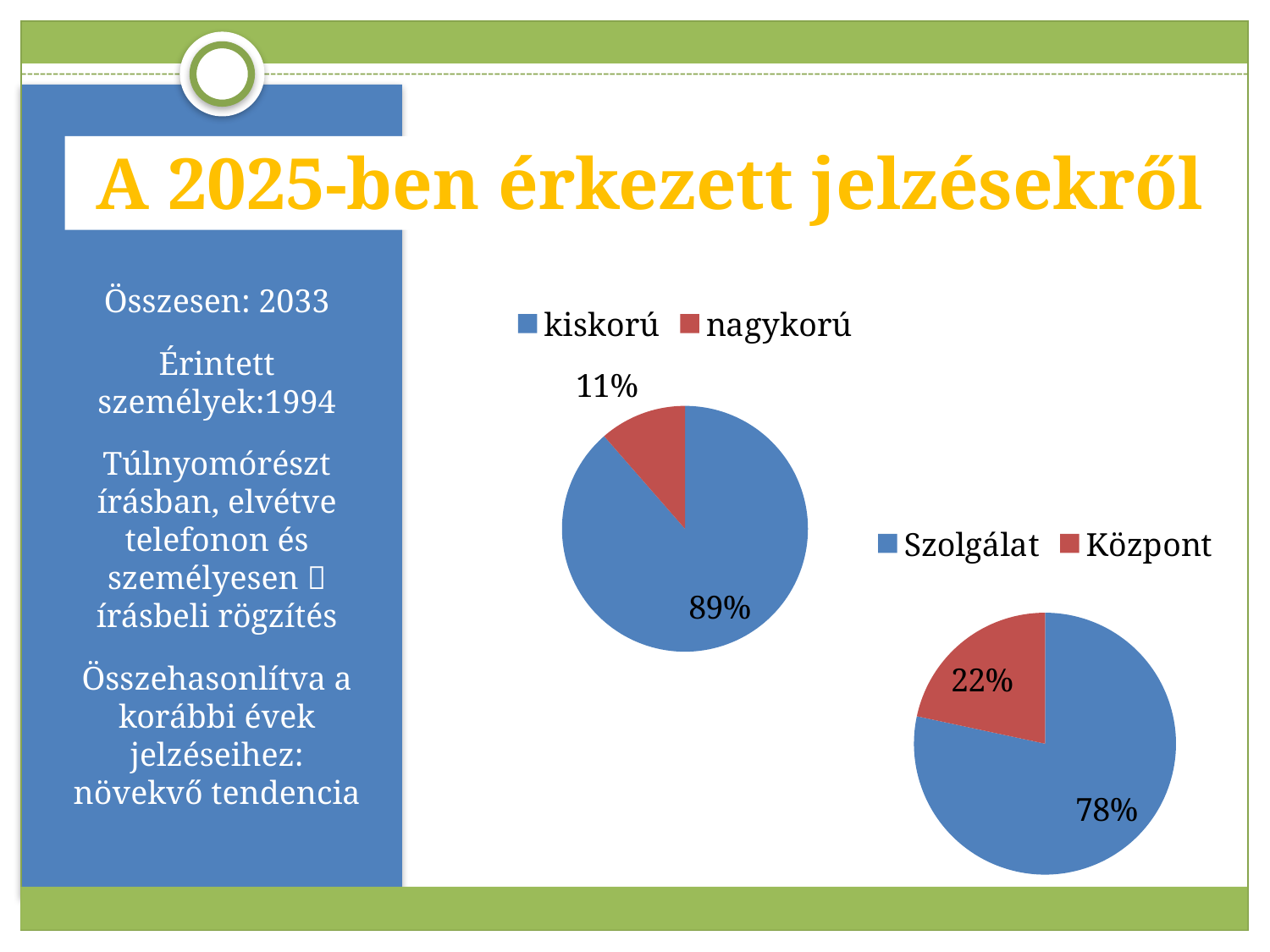
In the left pie chart (kiskorú / nagykorú), which category has the largest slice? kiskorú In the left pie chart (kiskorú / nagykorú), what colour is the nagykorú slice? Red What type of chart is the left chart (kiskorú / nagykorú)? Pie chart In the right pie chart (Szolgálat / Központ), which is larger, Szolgálat or Központ? Szolgálat In the right pie chart (Szolgálat / Központ), which category has the smallest slice? Központ In the left pie chart (kiskorú / nagykorú), what is the difference in percentage points between kiskorú and nagykorú? 78 percentage points In the left pie chart (kiskorú / nagykorú), what share does kiskorú have? 89% In the right pie chart (Szolgálat / Központ), what share does Szolgálat have? 78% In the right pie chart (Szolgálat / Központ), what is the difference in percentage points between Szolgálat and Központ? 56 percentage points In the left pie chart (kiskorú / nagykorú), what share does nagykorú have? 11% How many categories does the right pie chart (Szolgálat / Központ) show? 2